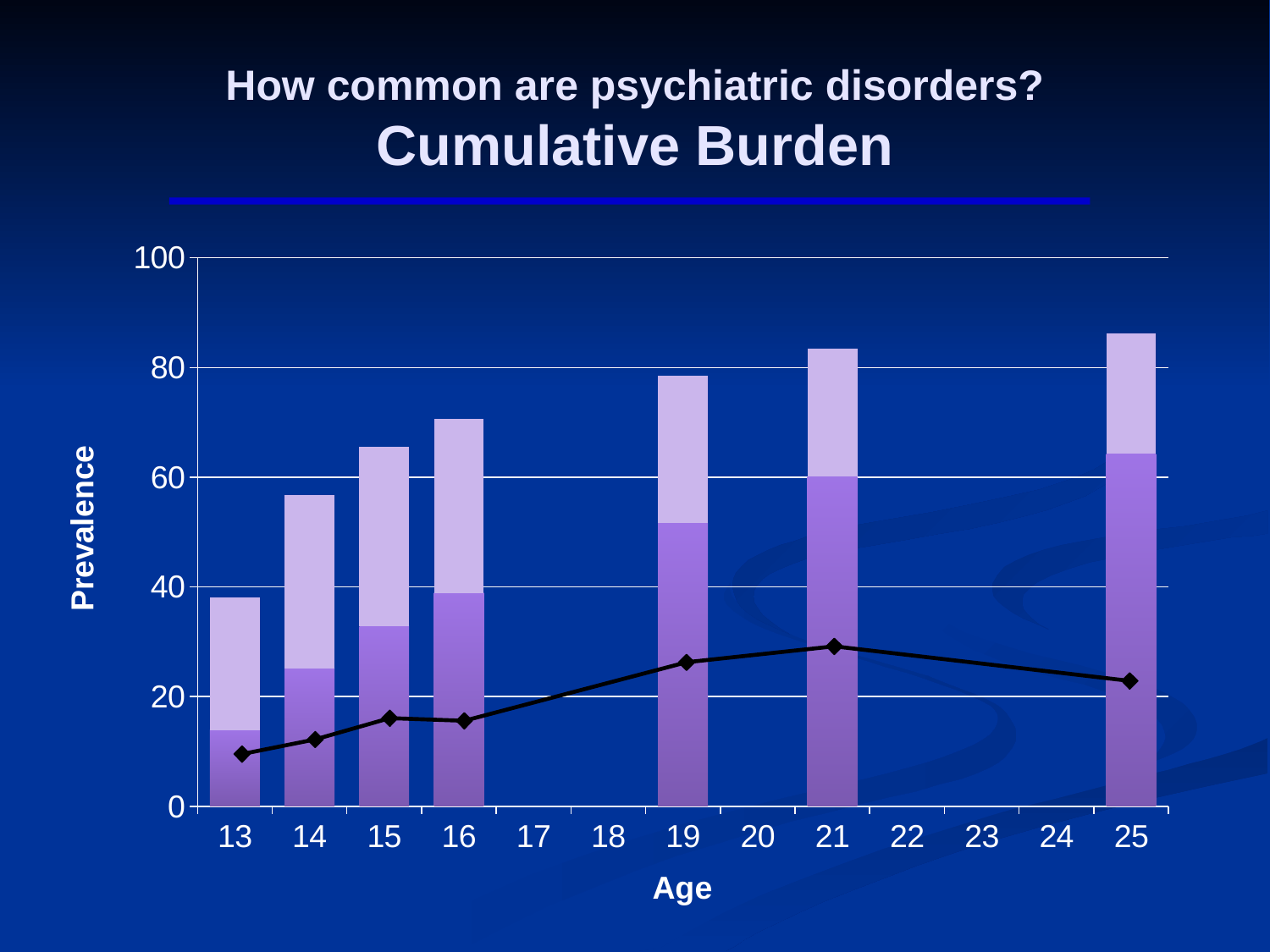
How many ages have a bar plotted in the chart? 7 What is the label on the vertical axis? Prevalence Which age has the lowest total bar height? 13 Is the line value at age 13 greater or less than 20? less Which has the taller total bar, age 14 or age 19? Age 19 Is the line value at age 21 greater or less than 20? greater What is the label on the horizontal axis? Age What kind of chart is shown on the slide? A stacked bar chart with a line overlay Is the total bar height for age 16 greater or less than 60? greater Do the total bar heights rise or fall as age increases from 13 to 25? Rise